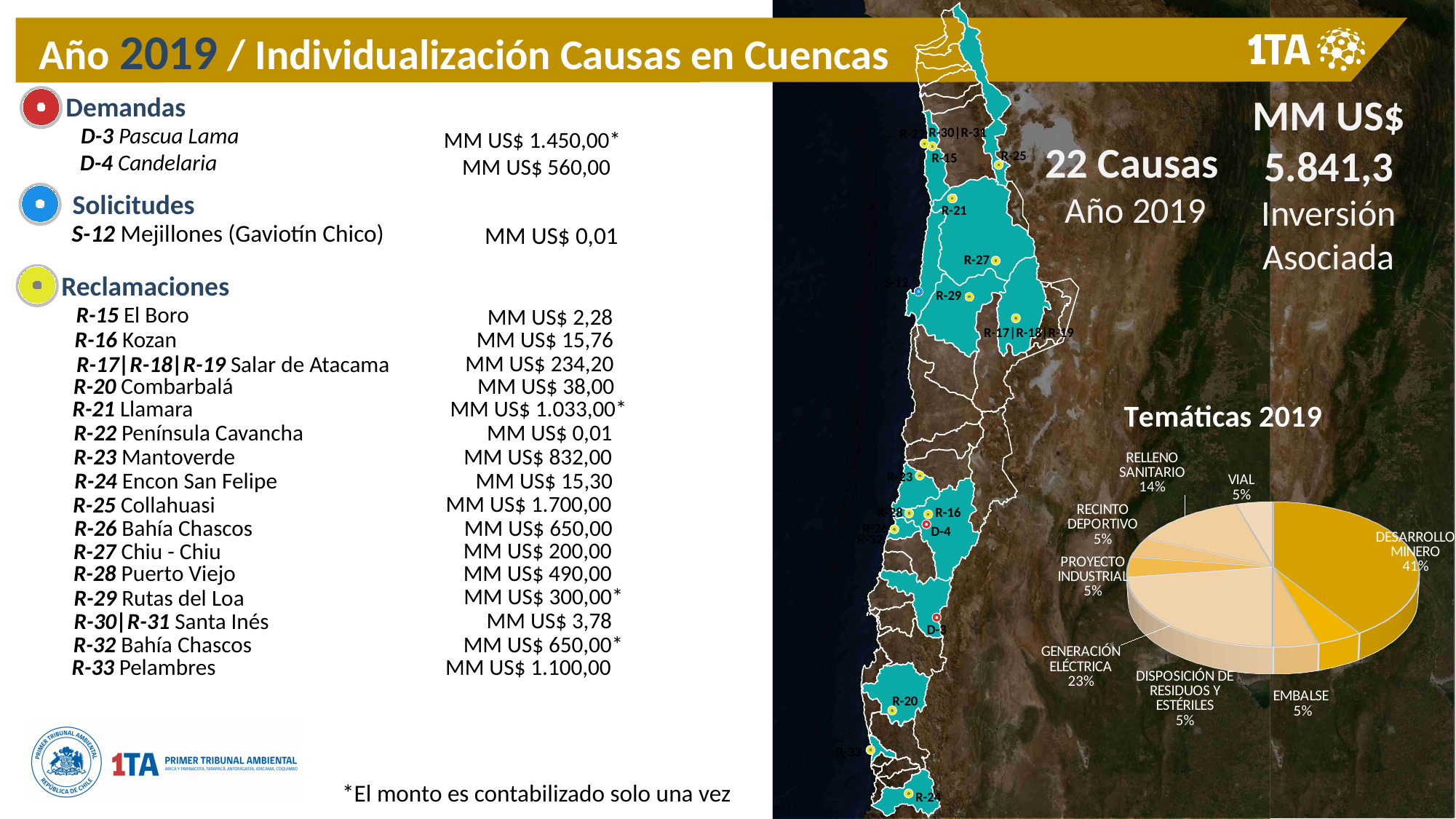
In the "Temáticas 2019" pie chart, what share does Desarrollo Minero have? 41% In the "Temáticas 2019" pie chart, what is the difference in percentage points between Generación Eléctrica and Relleno Sanitario? 9 In the "Temáticas 2019" pie chart, how many slices are there? 8 In the "Temáticas 2019" pie chart, which category has the largest slice? Desarrollo Minero What kind of chart is shown under the title "Temáticas 2019"? pie chart What is the title of the pie chart on the slide? Temáticas 2019 In the "Temáticas 2019" pie chart, what percentage is shown for Relleno Sanitario? 14% In the "Temáticas 2019" pie chart, how many categories are labelled with 5%? 5 In the "Temáticas 2019" pie chart, which is larger, Relleno Sanitario or Vial? Relleno Sanitario In the "Temáticas 2019" pie chart, what share does Generación Eléctrica have? 23% In the "Temáticas 2019" pie chart, what is the difference in percentage points between Desarrollo Minero and Generación Eléctrica? 18 In the "Temáticas 2019" pie chart, what percentage is shown for Embalse? 5%